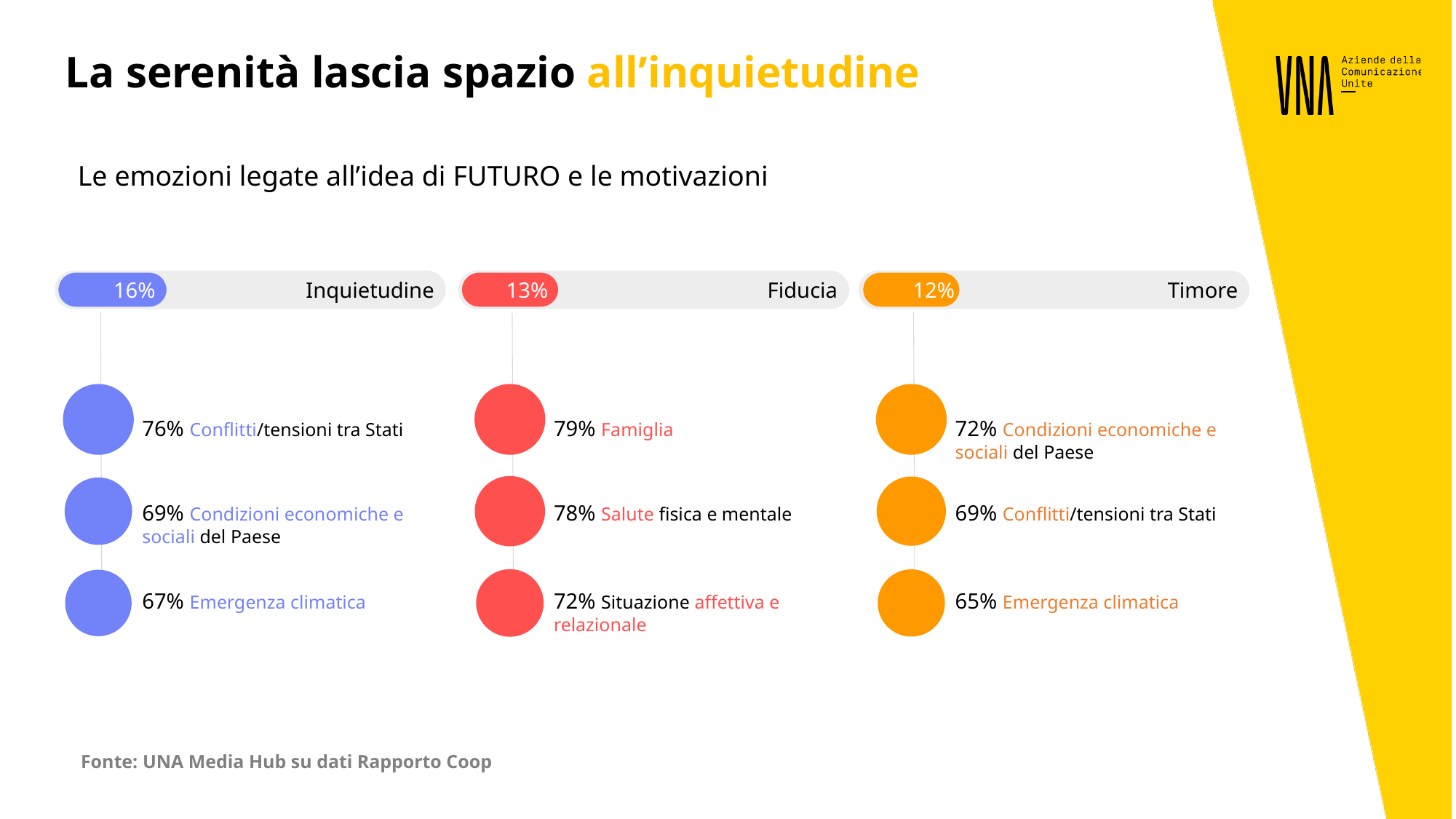
What percentage is shown for Inquietudine? 16% Which of the three emotions (Inquietudine, Fiducia, Timore) has the highest percentage? Inquietudine What is the difference in percentage points between Emergenza climatica under Inquietudine and Emergenza climatica under Timore? 2 How many emotions are shown in the top row of bars? 3 What percentage is shown for Timore? 12% Which is larger, the percentage for Fiducia or the percentage for Timore? Fiducia Under Inquietudine, what percentage is given for Conflitti/tensioni tra Stati? 76% What percentage is shown for Fiducia? 13% Under Timore, what percentage is given for Emergenza climatica? 65% Which of the three emotions (Inquietudine, Fiducia, Timore) has the lowest percentage? Timore Under Fiducia, what percentage is given for Famiglia? 79% What is the difference in percentage points between Inquietudine and Timore? 4